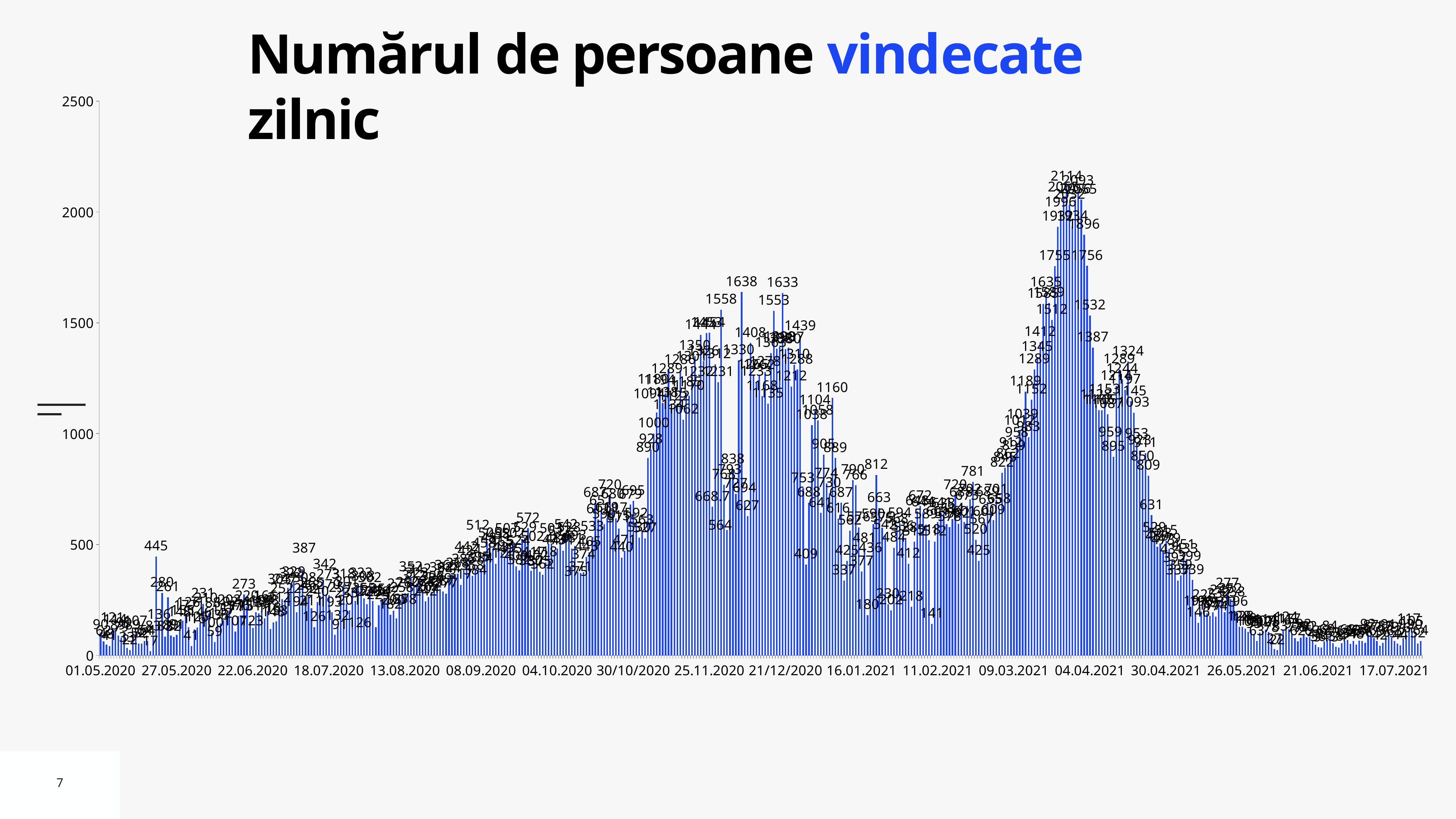
Are the values at the right end of the chart, around 17.07.2021, greater or less than 500? less What is the difference between the overall peak value of 2114 and the late-2020 peak value of 1638? 476 What kind of chart is shown on the slide? bar chart Which peak is higher: the one around 25.11.2020–21/12/2020 or the one around 04.04.2021? the one around 04.04.2021 Do the values rise or fall between 09.03.2021 and 04.04.2021? rise What is the highest value labelled in the late-2020 peak (around 25.11.2020 to 21/12/2020)? 1638 Is the highest bar on the chart greater or less than 2000? greater What is the highest value labelled on the chart? 2114 Are the values at the start of the chart, around 01.05.2020, greater or less than 500? less Do the values rise or fall between 04.04.2021 and 26.05.2021? fall What is the title of the chart? Numărul de persoane vindecate zilnic What is the highest tick value shown on the vertical axis? 2500